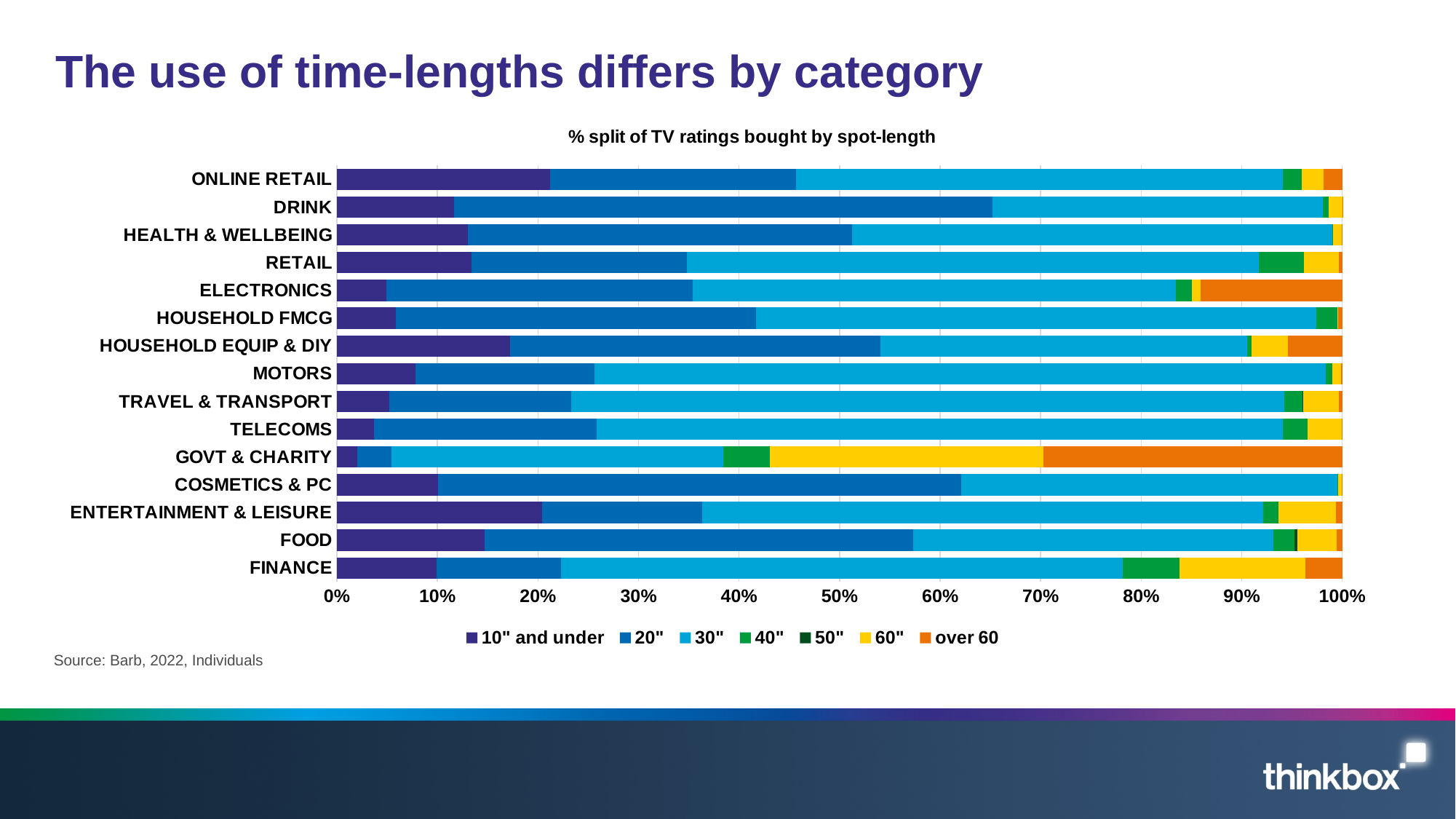
What type of chart is shown on the slide? Stacked bar chart How many series does the legend list? 7 Which is larger, the '20"' share for DRINK or the '20"' share for FINANCE? DRINK What does each stacked bar total? 100% Which category has the largest share for '20"'? DRINK Which category has the largest share for '60"'? GOVT & CHARITY Which category has the smallest share for '10" and under'? GOVT & CHARITY Is the '10" and under' share for ELECTRONICS greater or less than 10%? less What is the title of the chart? % split of TV ratings bought by spot-length How many categories are plotted on the chart? 15 Is the '10" and under' share for ONLINE RETAIL greater or less than 20%? greater Which category has the largest share for 'over 60'? GOVT & CHARITY